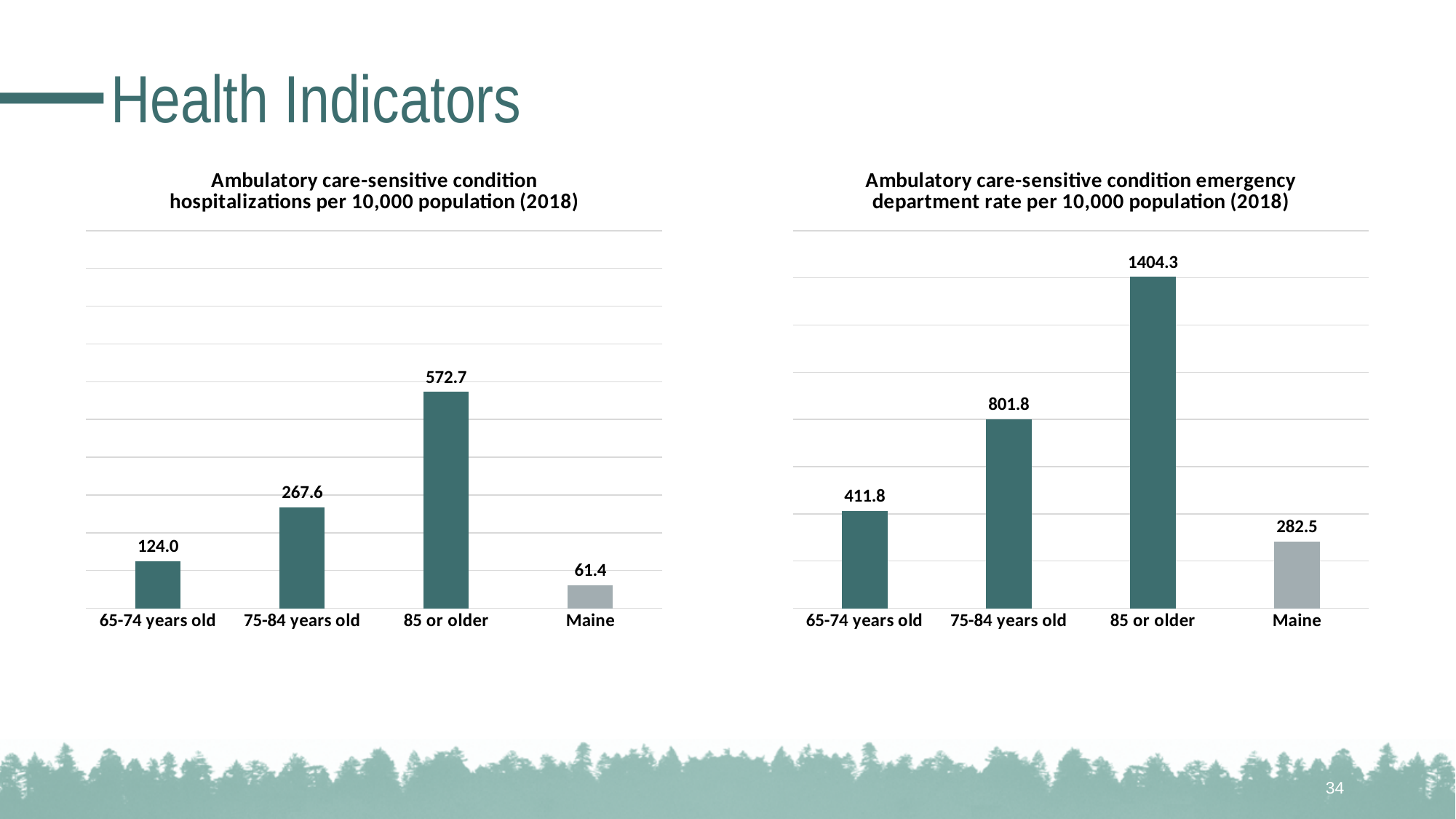
In the right chart (emergency department rate per 10,000 population), which category has the highest value? 85 or older In the right chart (emergency department rate per 10,000 population), what is the difference between the values for 65-74 years old and Maine? 129.3 In the left chart (hospitalizations per 10,000 population), which category has the lowest value? Maine In the left chart (hospitalizations per 10,000 population), what is the value for 85 or older? 572.7 In the left chart (hospitalizations per 10,000 population), what is the difference between the values for 85 or older and 75-84 years old? 305.1 In the right chart (emergency department rate per 10,000 population), do the values rise or fall across the three age groups from 65-74 years old to 85 or older? Rise What type of chart is the left chart (hospitalizations per 10,000 population)? Bar chart In the left chart (hospitalizations per 10,000 population), which is larger: the value for 65-74 years old or the value for Maine? 65-74 years old How many categories are shown in the right chart (emergency department rate per 10,000 population)? 4 In the left chart (hospitalizations per 10,000 population), what is the value for Maine? 61.4 In the right chart (emergency department rate per 10,000 population), what is the value for 65-74 years old? 411.8 In the right chart (emergency department rate per 10,000 population), what is the value for 75-84 years old? 801.8